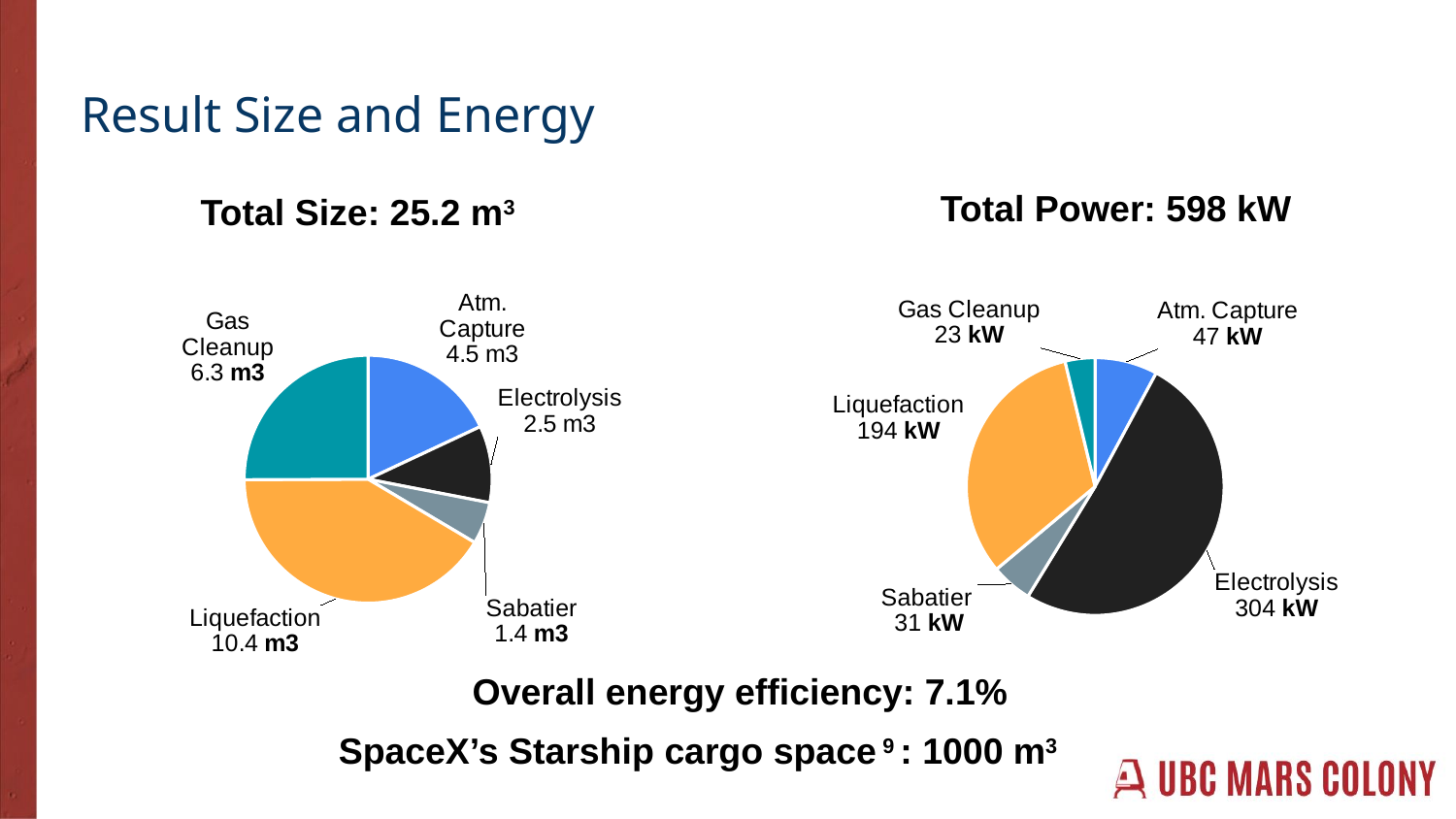
On the Total Size chart, what is the difference between Liquefaction and Gas Cleanup? 4.1 m3 On the Total Size chart, what is the value for Liquefaction? 10.4 m3 On the Total Power chart, roughly what share of the total does Electrolysis represent, to the nearest percent? 51% On the Total Size chart, which category has the smallest slice? Sabatier What is the total power shown in the title of the right-hand chart? 598 kW On the Total Power chart, which is larger, Atm. Capture or Gas Cleanup? Atm. Capture What kind of chart is the Total Power chart? Pie chart On the Total Power chart, how much larger is Electrolysis than Liquefaction? 110 kW On the Total Power chart, which category has the largest slice? Electrolysis On the Total Size chart, which is larger, Electrolysis or Atm. Capture? Atm. Capture How many categories does the Total Size chart show? 5 On the Total Power chart, what is the value for Sabatier? 31 kW